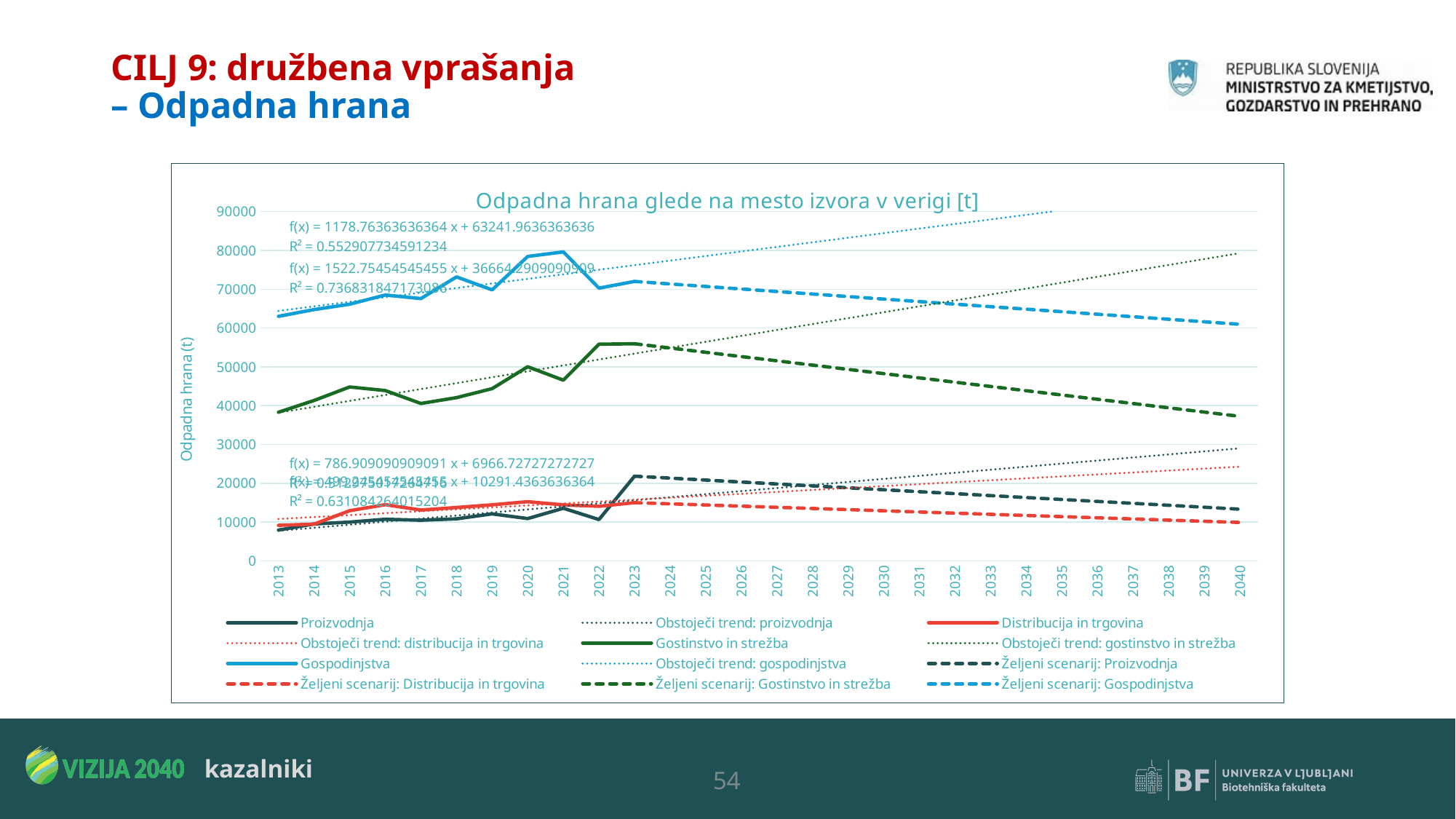
In 2023, which is higher: Gospodinjstva or Gostinstvo in strežba? Gospodinjstva How many years are shown on the x axis of the chart? 28 Is the value for Gospodinjstva in 2013 greater or less than 60000? greater What is the title of the chart? Odpadna hrana glede na mesto izvora v verigi [t] Is the value for Proizvodnja in 2013 greater or less than 10000? less What is the label of the y axis? Odpadna hrana (t) Is the value for Željeni scenarij: Gospodinjstva in 2040 greater or less than 70000? less How many series does the chart legend list? 12 Which series has the highest value in 2013? Gospodinjstva Does the Željeni scenarij: Gospodinjstva line rise or fall from 2024 to 2040? fall What kind of chart is shown on the slide? line chart